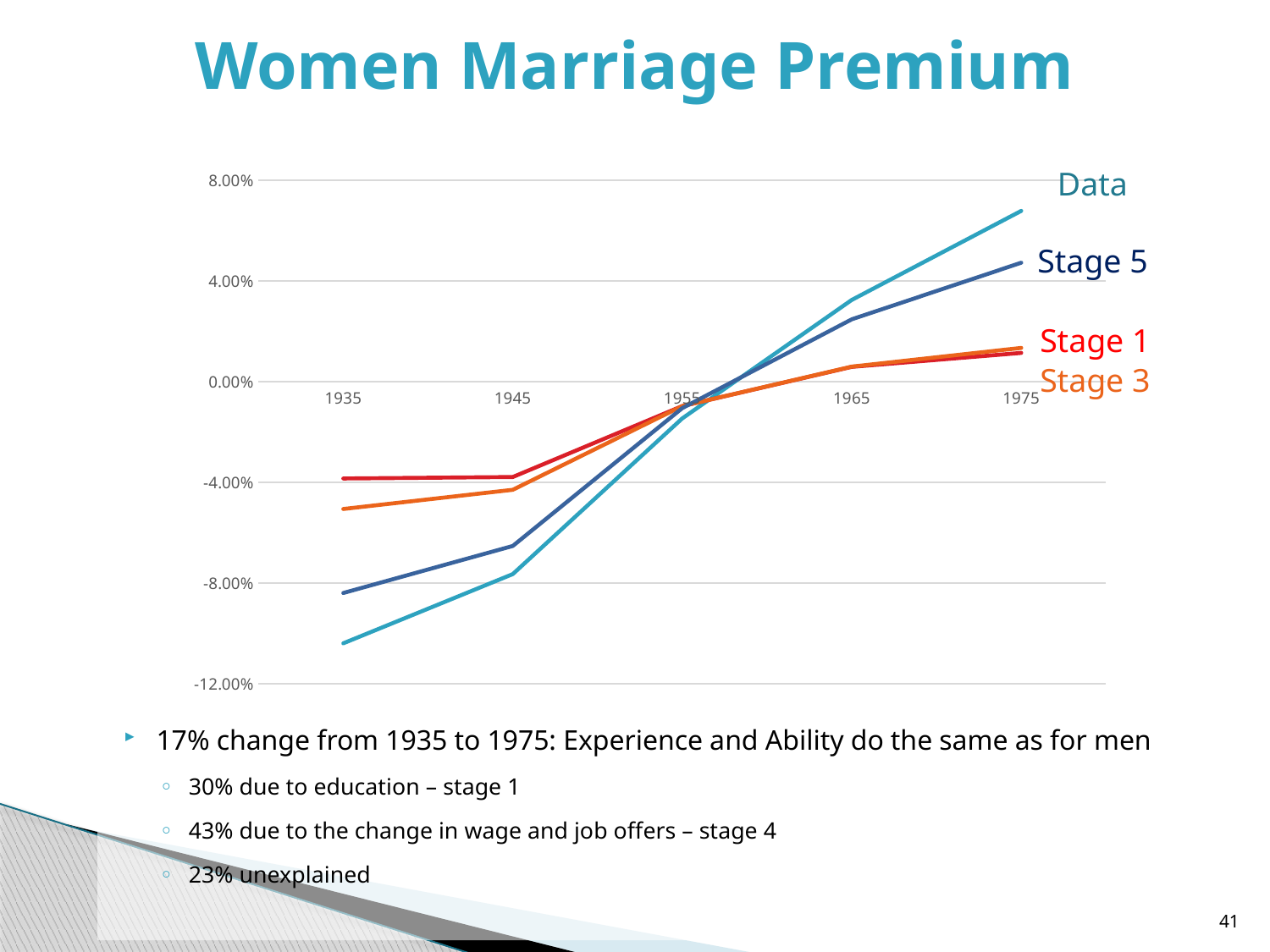
In 1935, which is higher: Stage 1 or Stage 3? Stage 1 Which series has the highest value in 1975? Data Is the value of the Stage 3 series in 1935 greater or less than -4.00%? less What kind of chart is shown on the slide? line chart Does the Data series rise or fall from 1935 to 1975? rise Is the value of the Data series in 1975 greater or less than 4.00%? greater How many years are marked on the x axis of the chart? 5 Which series has the lowest value in 1935? Data Is the value of the Data series in 1935 greater or less than -8.00%? less What is the title of the slide containing the chart? Women Marriage Premium How many series are labelled on the chart? 4